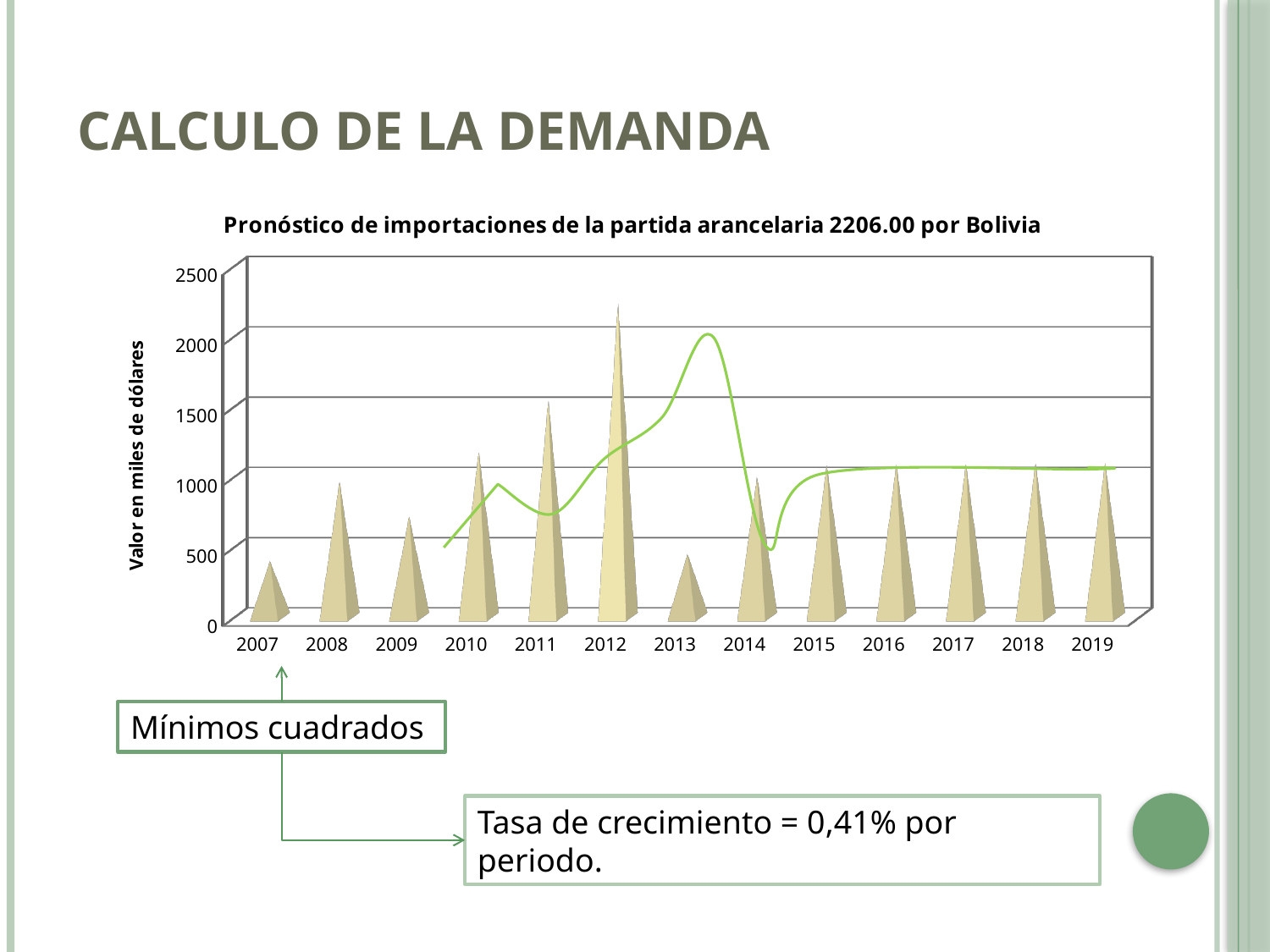
Do the bar values rise or fall from 2009 to 2012? rise What is the title of the chart? Pronóstico de importaciones de la partida arancelaria 2206.00 por Bolivia Is the value for 2011 greater or less than 1000? greater Which is larger, the value for 2012 or the value for 2014? 2012 Which is larger, the value for 2011 or the value for 2010? 2011 Which year has the highest bar? 2012 What kind of chart is shown on the slide? Bar chart Is the value for 2012 greater or less than 2000? greater What is the label of the vertical axis? Valor en miles de dólares How many years are shown on the x axis? 13 Is the value for 2007 greater or less than 500? less